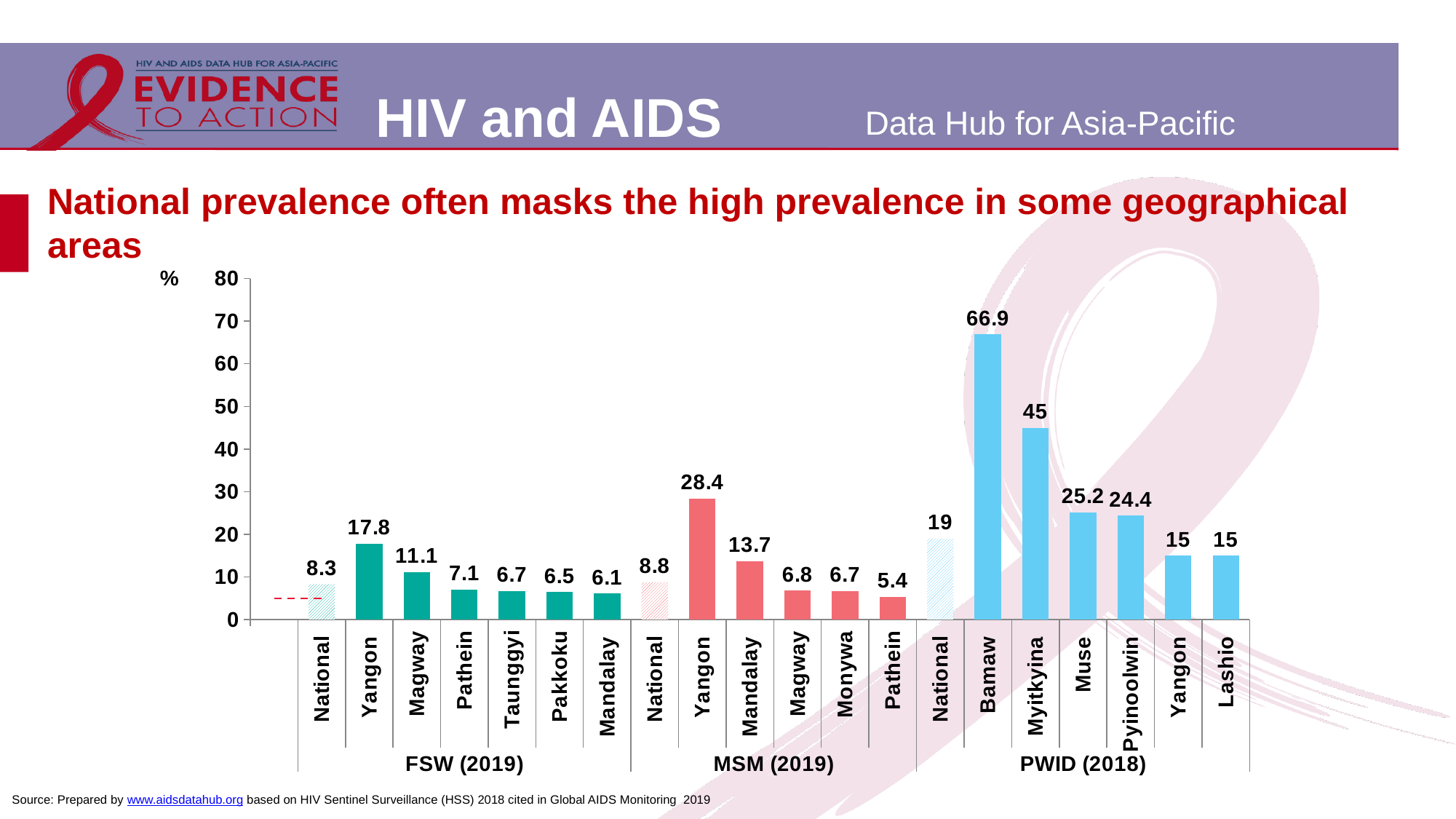
What type of chart is shown on the slide? Bar chart What is the difference between the Bamaw and Myitkyina values in the PWID (2018) group? 21.9 Which location has the highest bar in the whole chart? Bamaw What is the difference between the Yangon value and the National value in the FSW (2019) group? 9.5 What is the HIV prevalence value shown for Bamaw in the PWID (2018) group? 66.9 How many locations (including National) are shown in the PWID (2018) group? 7 What unit is indicated on the y-axis of the chart? % What is the value shown for Yangon in the MSM (2019) group? 28.4 What is the National value shown for FSW (2019)? 8.3 How many bars are plotted in the chart in total? 20 Which is larger: the Mandalay value for MSM (2019) or the Magway value for FSW (2019)? Mandalay value for MSM (2019) Which location has the lowest value in the MSM (2019) group? Pathein